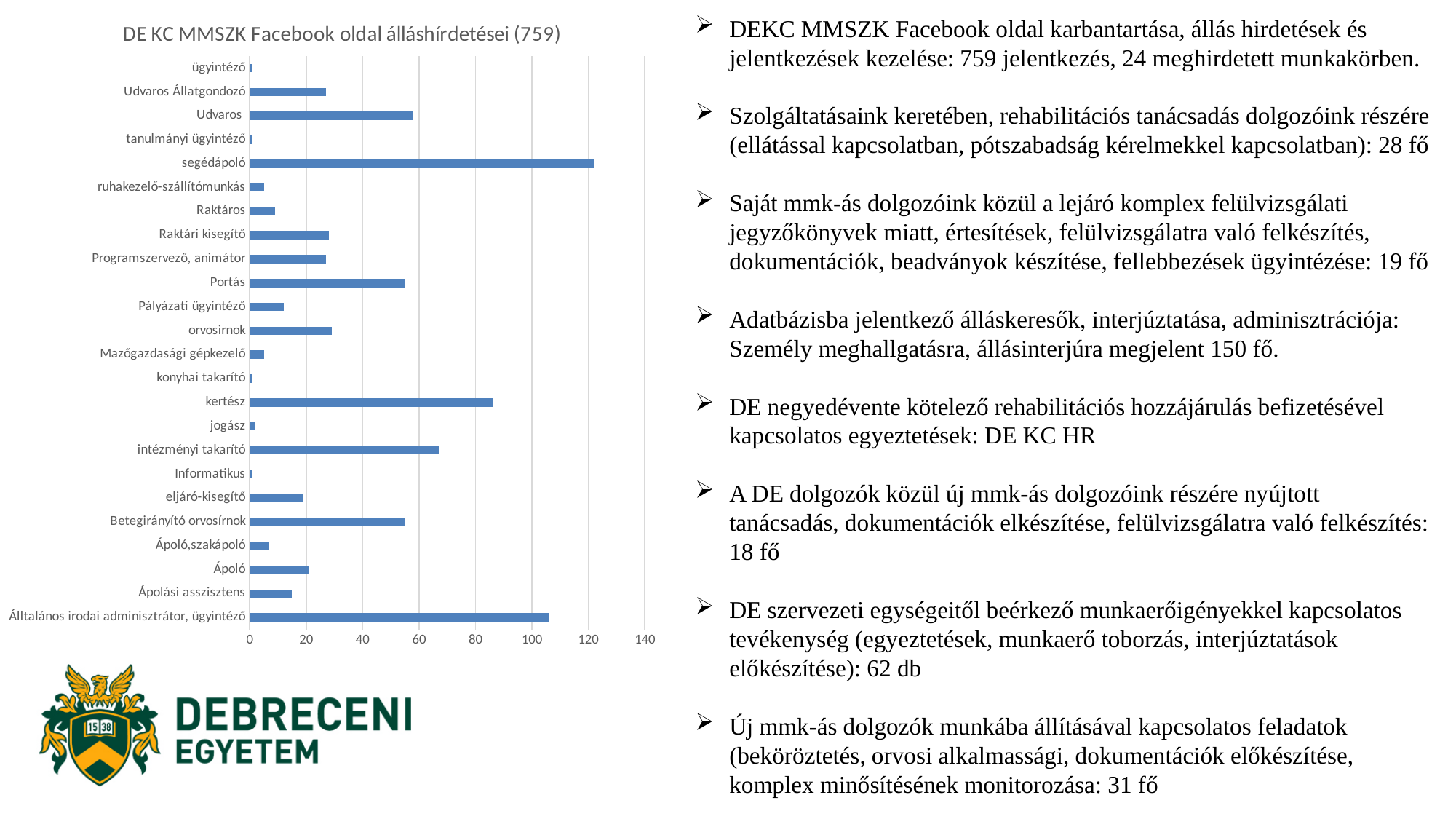
How many categories (job titles) are plotted in the chart? 24 Which has a larger value, Álltalános irodai adminisztrátor, ügyintéző or kertész? Álltalános irodai adminisztrátor, ügyintéző Is the value for intézményi takarító greater or less than 60? greater Is the value for segédápoló greater or less than 100? greater What kind of chart is shown on the slide? bar chart Which category has the highest value in the chart? segédápoló Is the value for Álltalános irodai adminisztrátor, ügyintéző greater or less than 100? greater Which has a larger value, Ápoló or Ápolási asszisztens? Ápoló What is the title of the chart? DE KC MMSZK Facebook oldal álláshírdetései (759) Which has a larger value, segédápoló or kertész? segédápoló